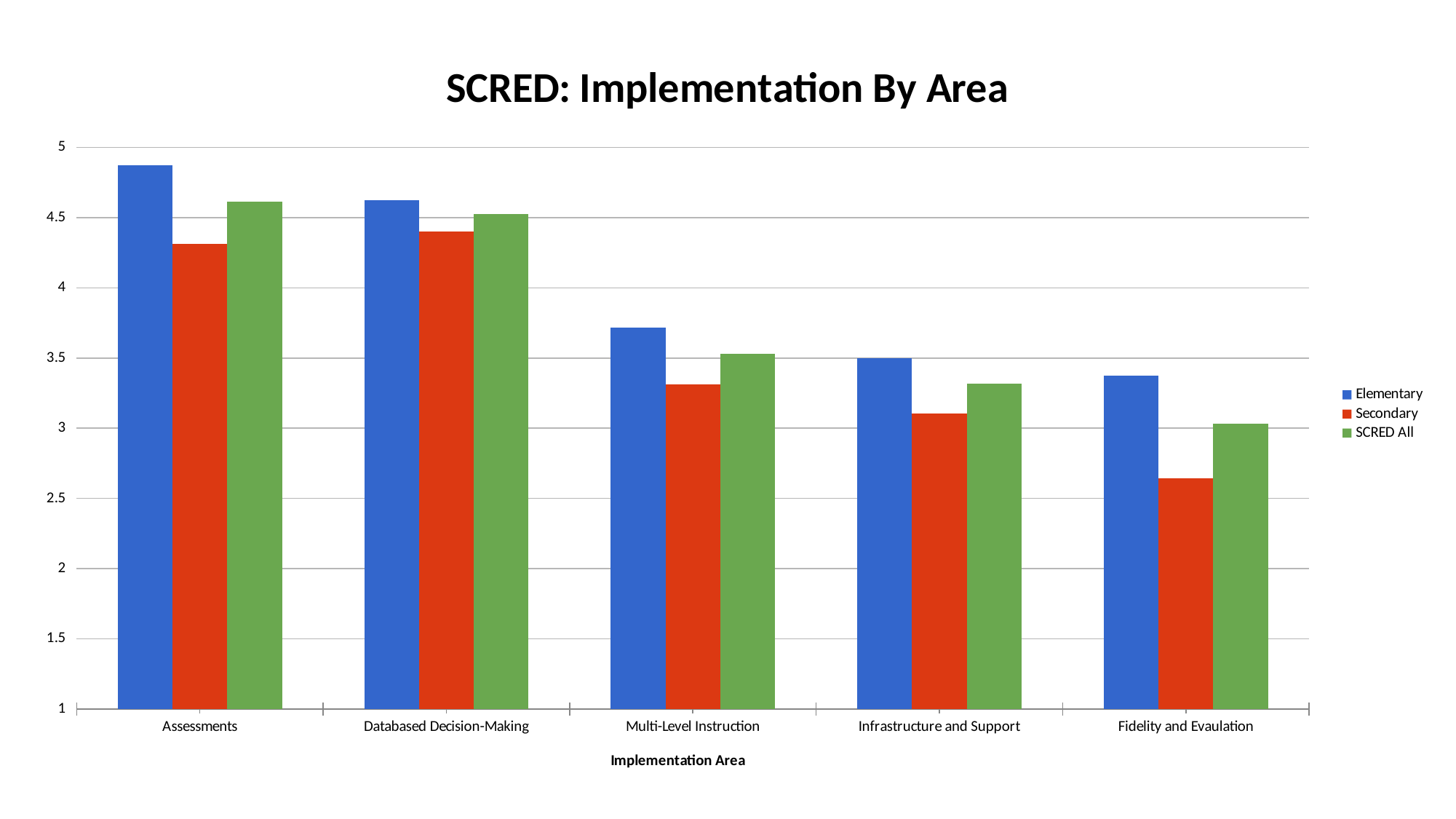
Which implementation area has the lowest Secondary value? Fidelity and Evaulation Is the Secondary value for Fidelity and Evaulation greater or less than 3? less How many implementation areas are shown on the x axis? 5 What kind of chart is shown on the slide? bar chart What is the title of the chart? SCRED: Implementation By Area For Multi-Level Instruction, which is larger: the SCRED All value or the Secondary value? SCRED All Is the Elementary value for Assessments greater or less than 4.5? greater Which implementation area has the highest Elementary value? Assessments For Assessments, which is larger: the Elementary value or the Secondary value? Elementary Do the Elementary values rise or fall moving from left to right across the implementation areas? fall Is the Secondary value for Multi-Level Instruction greater or less than 3.5? less How many series does the legend list? 3